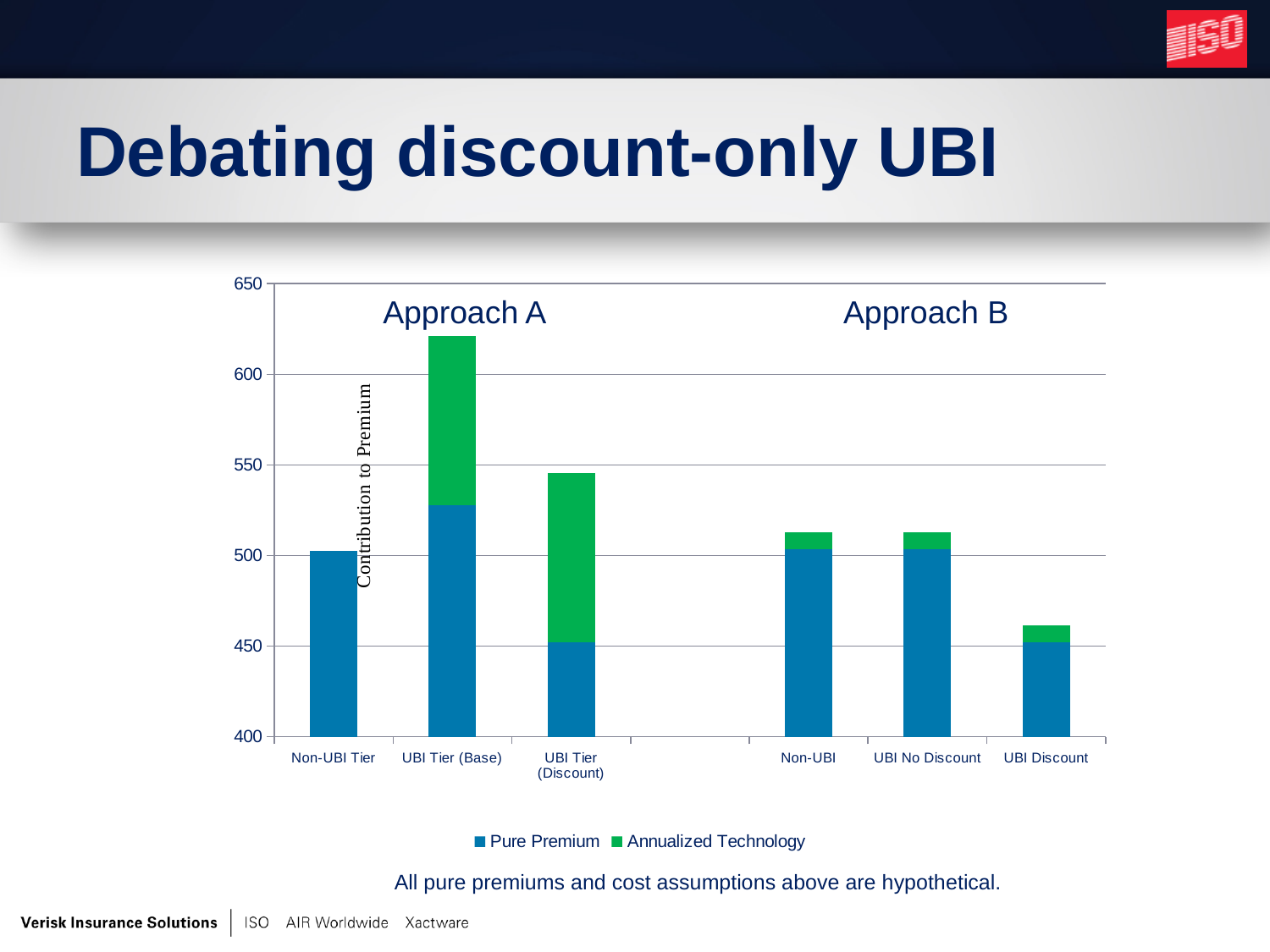
Is the Pure Premium value for UBI Tier (Base) greater or less than 500? greater Which series is shown in green? Annualized Technology Is the total for UBI Tier (Base) greater or less than 600? greater How many series does the legend list? 2 Which has the larger total bar, UBI Tier (Base) or UBI Tier (Discount)? UBI Tier (Base) How many labeled categories are shown on the x axis? 6 What kind of chart is shown on the slide? Stacked bar chart Which category has the highest total bar? UBI Tier (Base) Which has the larger Annualized Technology segment, UBI Tier (Base) or Non-UBI? UBI Tier (Base) What is the title of the vertical axis? Contribution to Premium Is the total for UBI Discount greater or less than 500? less Which category has the lowest total bar? UBI Discount